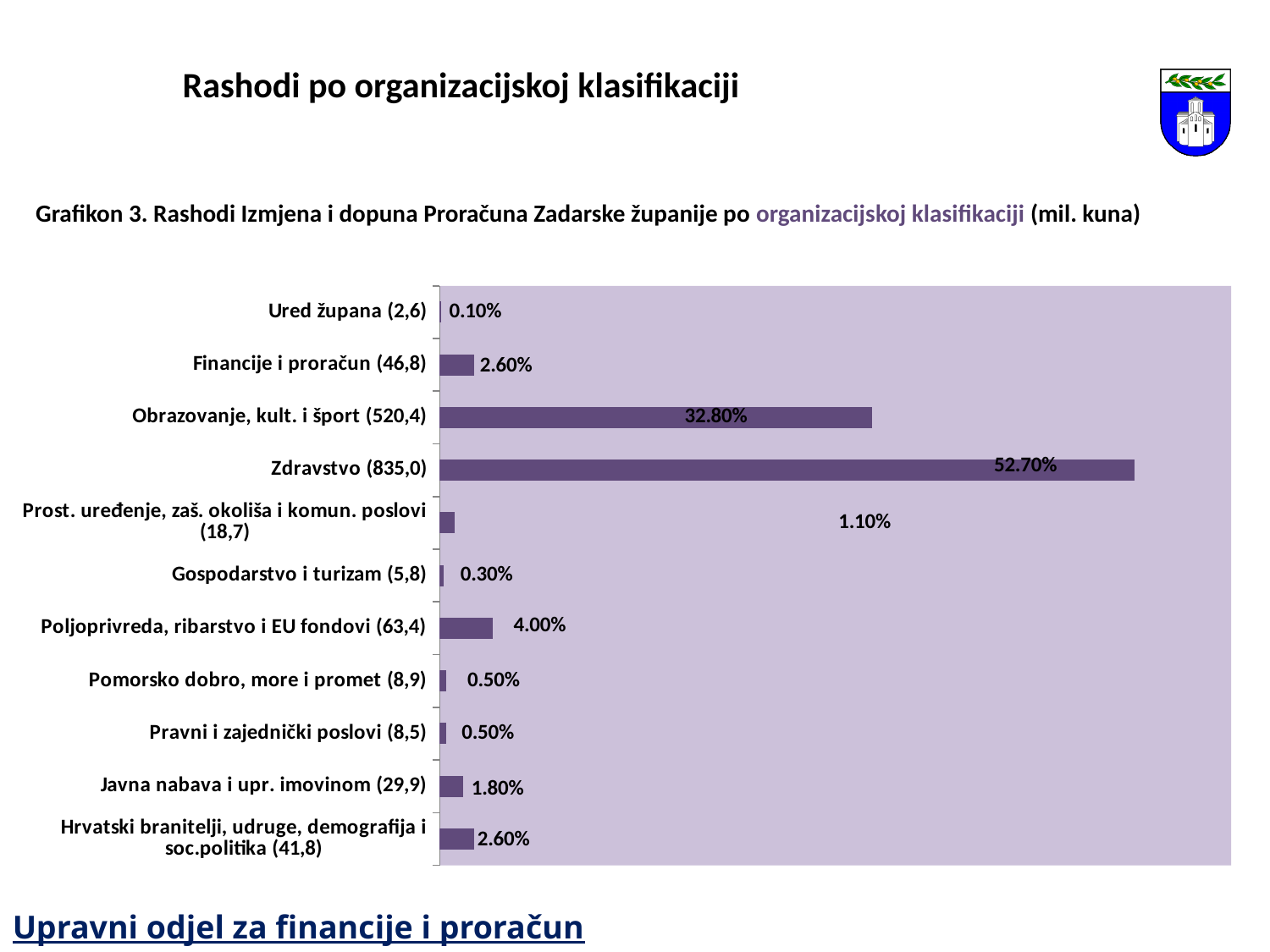
How many categories are shown in the chart? 11 Which category has the lowest value? Ured župana (2,6) What kind of chart is shown on the slide? Bar chart What unit is given in parentheses in the chart title? mil. kuna What is the value shown for Obrazovanje, kult. i šport (520,4)? 32.80% What is the value shown for Poljoprivreda, ribarstvo i EU fondovi (63,4)? 4.00% What is the value shown for Zdravstvo (835,0)? 52.70% Which category has the highest value? Zdravstvo (835,0) Which is larger, the value for Financije i proračun (46,8) or the value for Poljoprivreda, ribarstvo i EU fondovi (63,4)? Poljoprivreda, ribarstvo i EU fondovi (63,4) What is the difference between the values for Prost. uređenje, zaš. okoliša i komun. poslovi (18,7) and Gospodarstvo i turizam (5,8)? 0.80% What is the value shown for Javna nabava i upr. imovinom (29,9)? 1.80% What is the difference between the values for Zdravstvo (835,0) and Obrazovanje, kult. i šport (520,4)? 19.90%